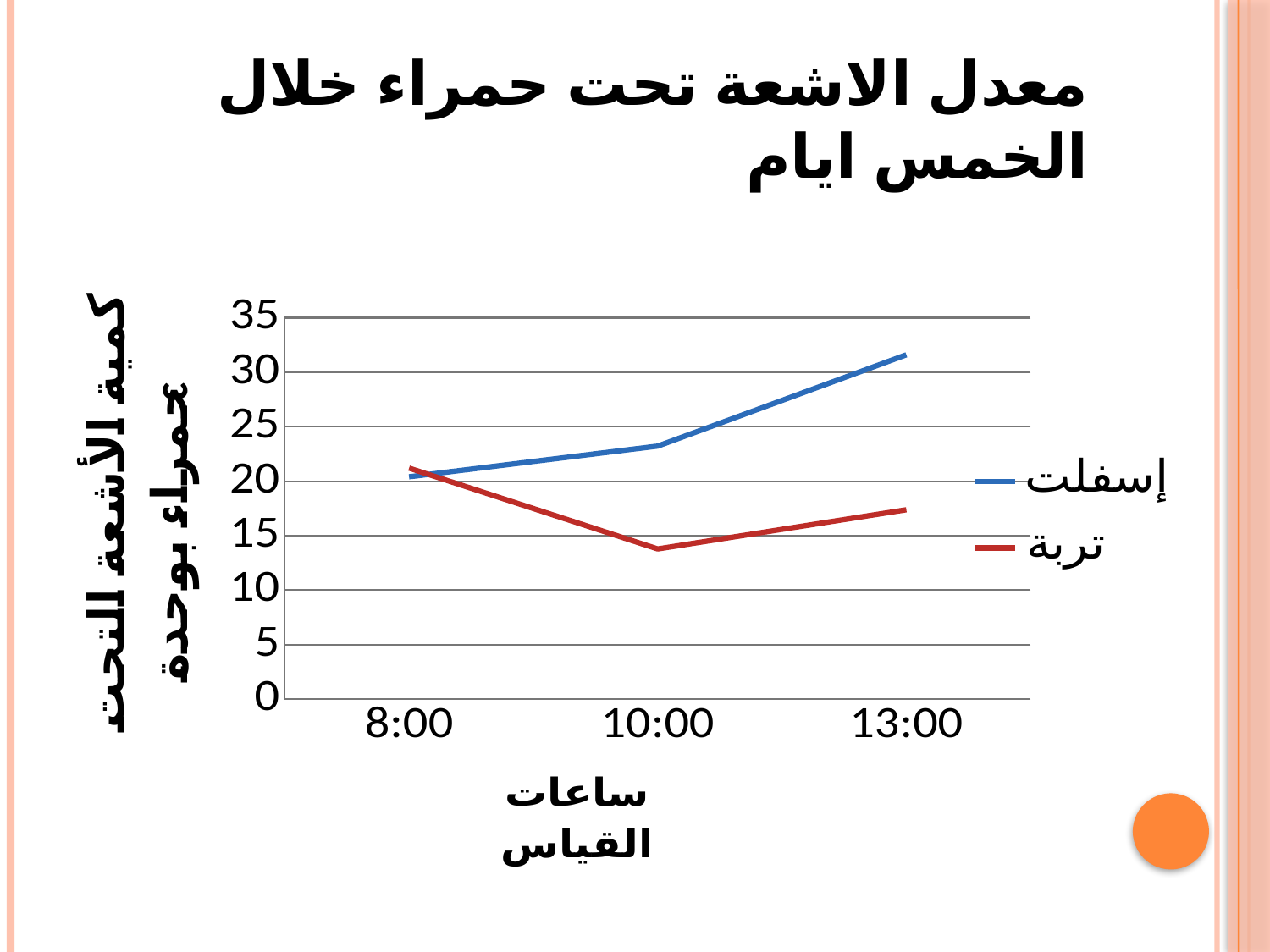
How many series does the legend list? 2 Is the value for تربة at 10:00 greater or less than 15? less What kind of chart is shown on the slide? line chart At which time does the إسفلت series reach its highest value? 13:00 How many time points are plotted along the x axis? 3 At which time does the تربة series reach its lowest value? 10:00 Is the value for إسفلت at 13:00 greater or less than 30? greater What is the label of the x axis? ساعات القياس Does the value for إسفلت rise or fall from 8:00 to 13:00? rise At 13:00, which series has the larger value, إسفلت or تربة? إسفلت Is the value for تربة at 13:00 greater or less than 20? less